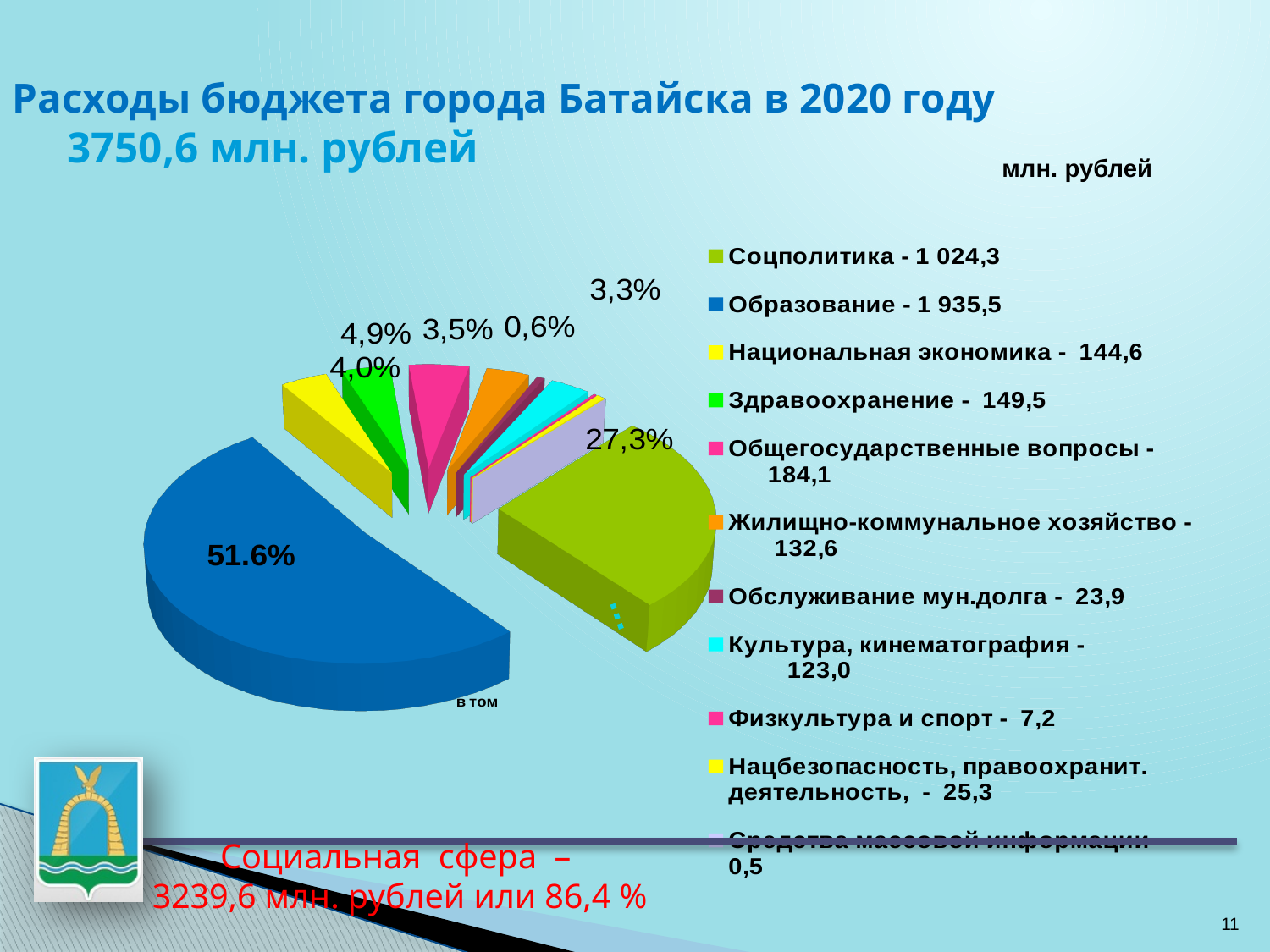
What is the value for Образование in the legend? 1 935,5 How many categories are listed in the legend? 11 Which category has the largest expenditure? Образование What is the difference between Образование and Соцполитика? 911,2 What is the difference between Здравоохранение and Национальная экономика? 4,9 Which category has the smallest expenditure? Средства массовой информации Which is larger: Общегосударственные вопросы or Жилищно-коммунальное хозяйство? Общегосударственные вопросы What share of the pie does the Образование slice represent? 51.6% What kind of chart is shown on the slide? pie chart What is the value for Соцполитика in the legend? 1 024,3 What share of the pie does the Соцполитика slice represent? 27,3% What is the value for Культура, кинематография? 123,0